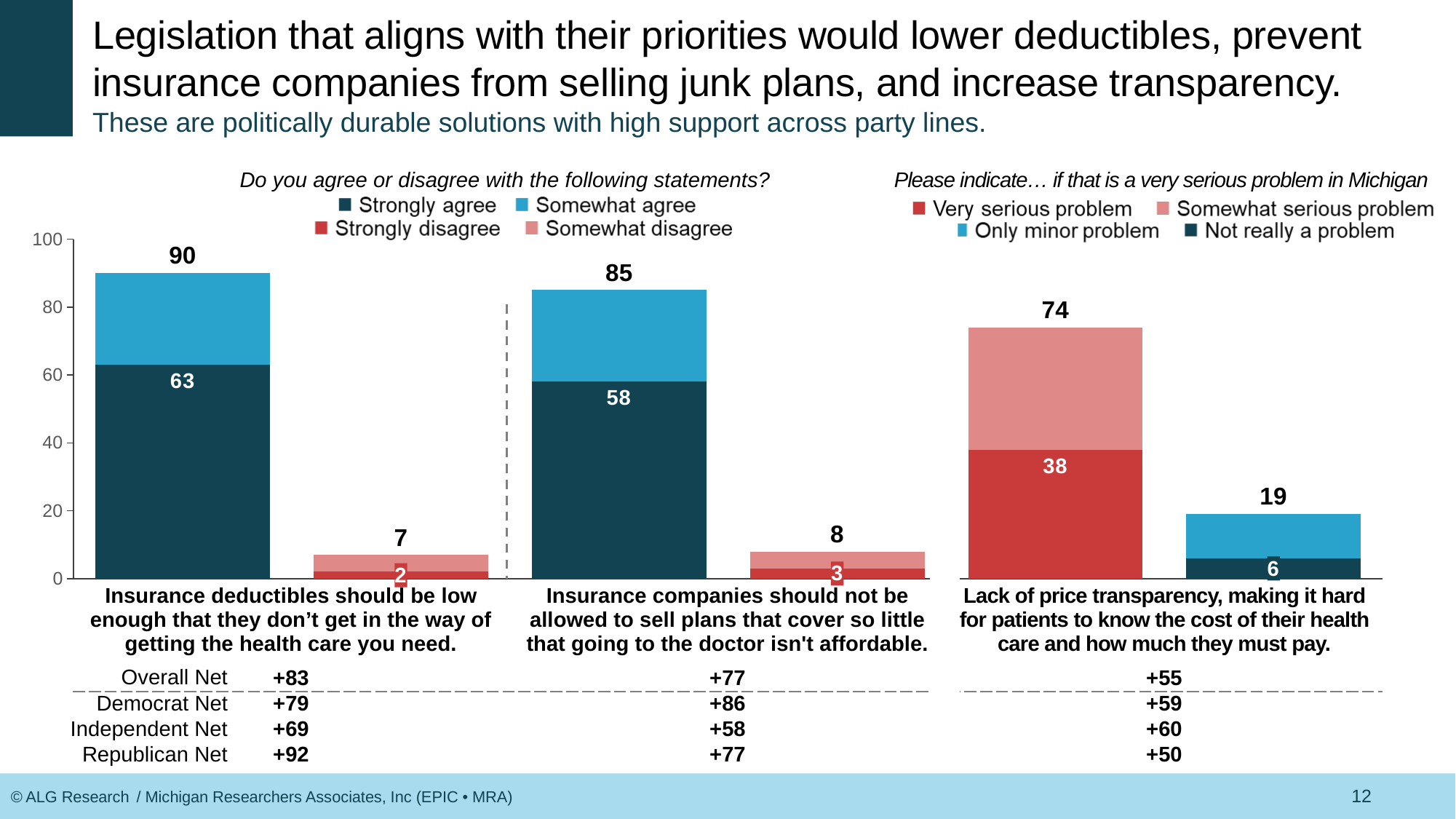
In the 'Do you agree or disagree' chart, what percentage strongly agree that insurance deductibles should be low enough that they don't get in the way of getting the health care you need? 63 In the 'Do you agree or disagree' chart, which statement has the highest total agree value? Insurance deductibles should be low enough that they don't get in the way of getting the health care you need. In the 'very serious problem in Michigan' chart, what percentage say lack of price transparency is a very serious problem? 38 In the 'Do you agree or disagree' chart, what is the difference between the total agree values for the deductibles statement and the junk plans statement? 5 In the 'Do you agree or disagree' chart, which statement has the larger strongly agree value: the deductibles statement or the junk plans statement? The deductibles statement How many series does the legend of the 'Do you agree or disagree' chart list? 4 In the 'very serious problem in Michigan' chart, what is the somewhat serious problem value for lack of price transparency (total serious minus very serious)? 36 In the 'Do you agree or disagree' chart, what is the total agree value for the statement that insurance companies should not be allowed to sell plans that cover so little that going to the doctor isn't affordable? 85 In the 'very serious problem in Michigan' chart, what percentage say lack of price transparency is not really a problem? 6 In the 'Do you agree or disagree' chart, what is the somewhat agree value for the deductibles statement (total agree minus strongly agree)? 27 In the 'Do you agree or disagree' chart, what is the total disagree value for the junk plans statement? 8 What kind of chart is used on this slide? Stacked bar chart